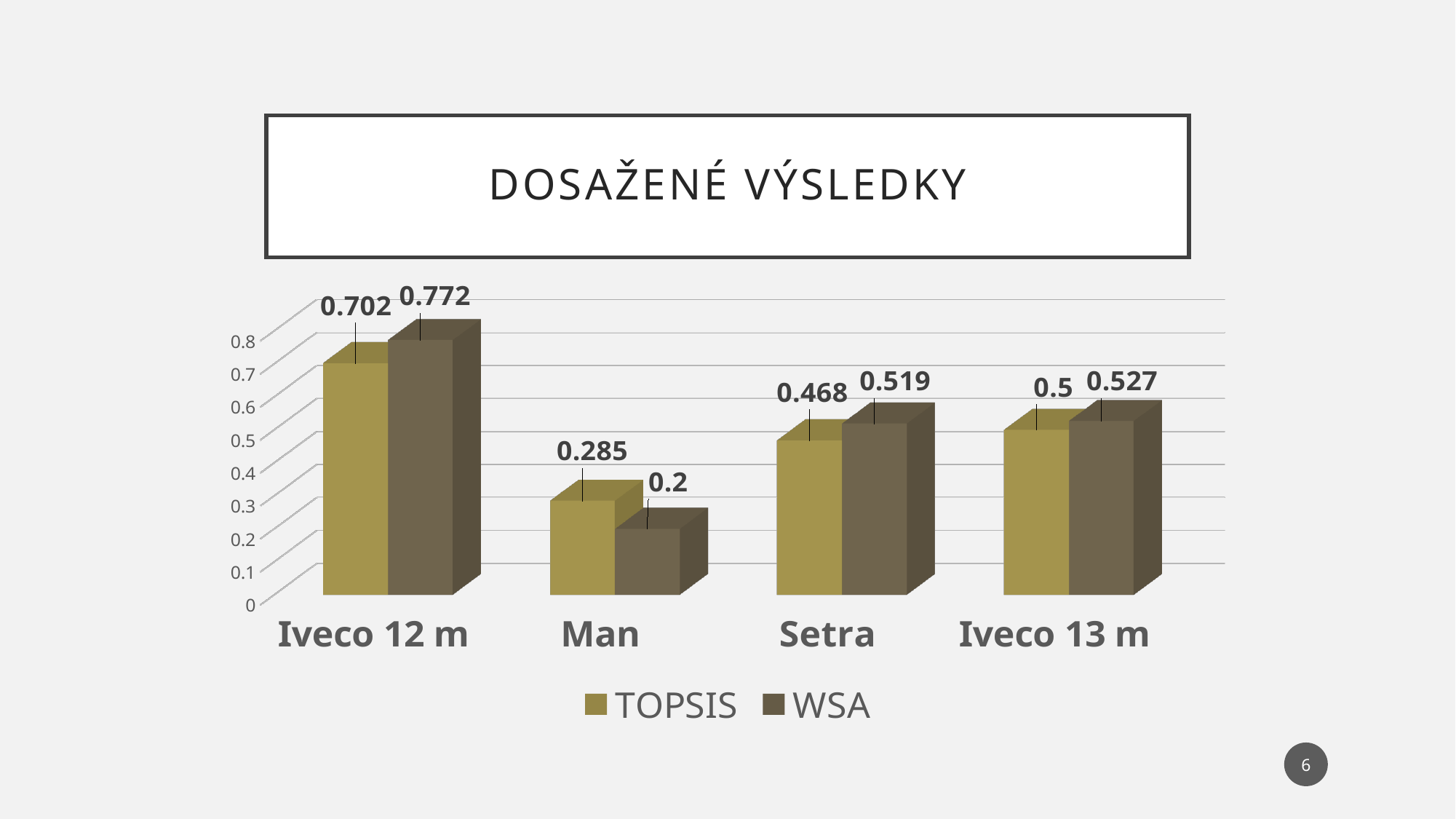
How many series does the legend list? 2 For Man, which is larger: the TOPSIS value or the WSA value? TOPSIS What is the WSA value for Man? 0.2 What is the TOPSIS value for Iveco 13 m? 0.5 How many categories are shown on the x axis? 4 What is the difference between the WSA and TOPSIS values for Iveco 12 m? 0.07 Which category has the lowest TOPSIS value? Man What is the TOPSIS value for Iveco 12 m? 0.702 What is the WSA value for Setra? 0.519 What kind of chart is shown on the slide? Bar chart Which category has the highest WSA value? Iveco 12 m What is the title of the slide? DOSAŽENÉ VÝSLEDKY